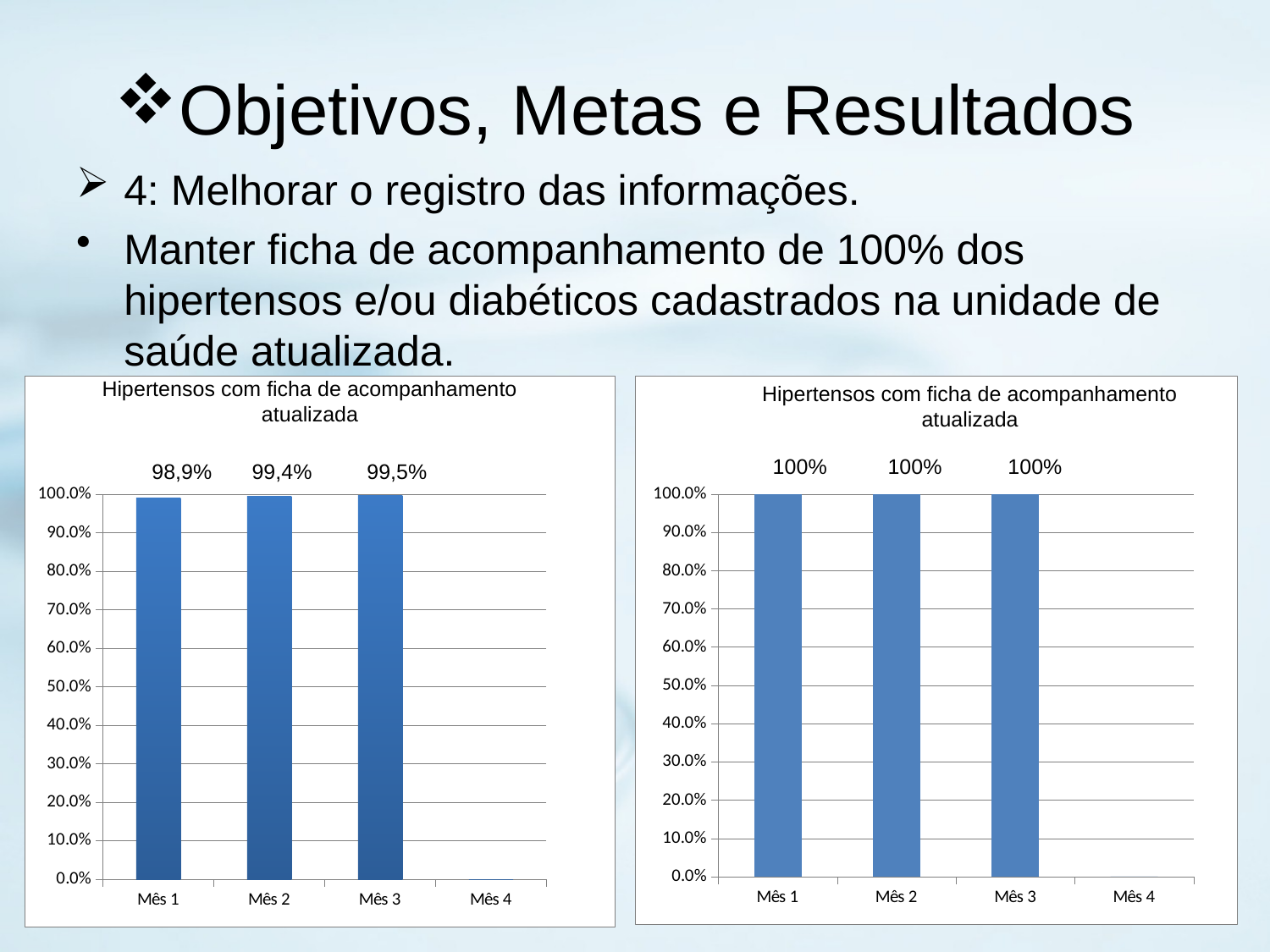
How many month categories are labelled on the x axis of the right chart? 4 In the left chart, which is larger, the value for Mês 2 or the value for Mês 1? Mês 2 In the left chart, what is the difference between the values for Mês 3 and Mês 1? 0,6% In the left chart, what is the value for Mês 1? 98,9% What is the title of the right chart? Hipertensos com ficha de acompanhamento atualizada In the left chart, do the values rise or fall from Mês 1 to Mês 3? Rise In the left chart, which month has the highest value? Mês 3 In the right chart, what is the value for Mês 2? 100% In the left chart, what is the value for Mês 3? 99,5% In the left chart, is the value for Mês 2 greater or less than 90.0%? greater What kind of chart is the left chart? Bar chart